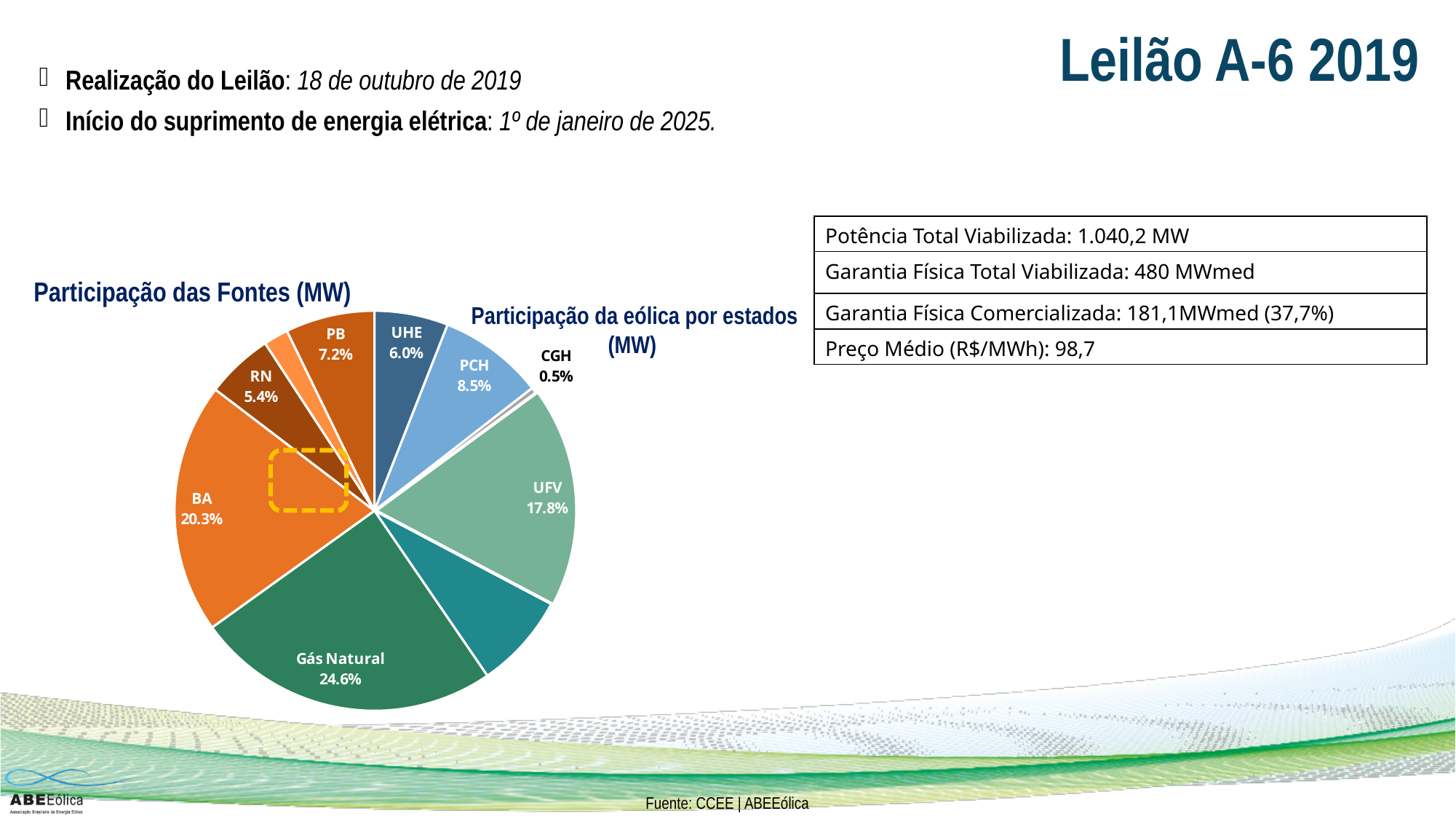
What share of the pie does Gás Natural hold in the 'Participação das Fontes (MW)' chart? 24.6% What percentage is shown for CGH in the pie chart? 0.5% By how many percentage points does the Gás Natural slice exceed the BA slice? 4.3 percentage points What percentage is shown for UFV in the pie chart? 17.8% What percentage is shown for BA in the pie chart? 20.3% What percentage is shown for RN in the pie chart? 5.4% What is the title of the chart on the left of the slide? Participação das Fontes (MW) What percentage is shown for PCH in the pie chart? 8.5% What percentage is shown for UHE in the pie chart? 6.0% What type of chart is shown on the slide? Pie chart Which slice is larger in the pie chart, BA or UFV? BA Which labeled slice is the largest in the pie chart? Gás Natural